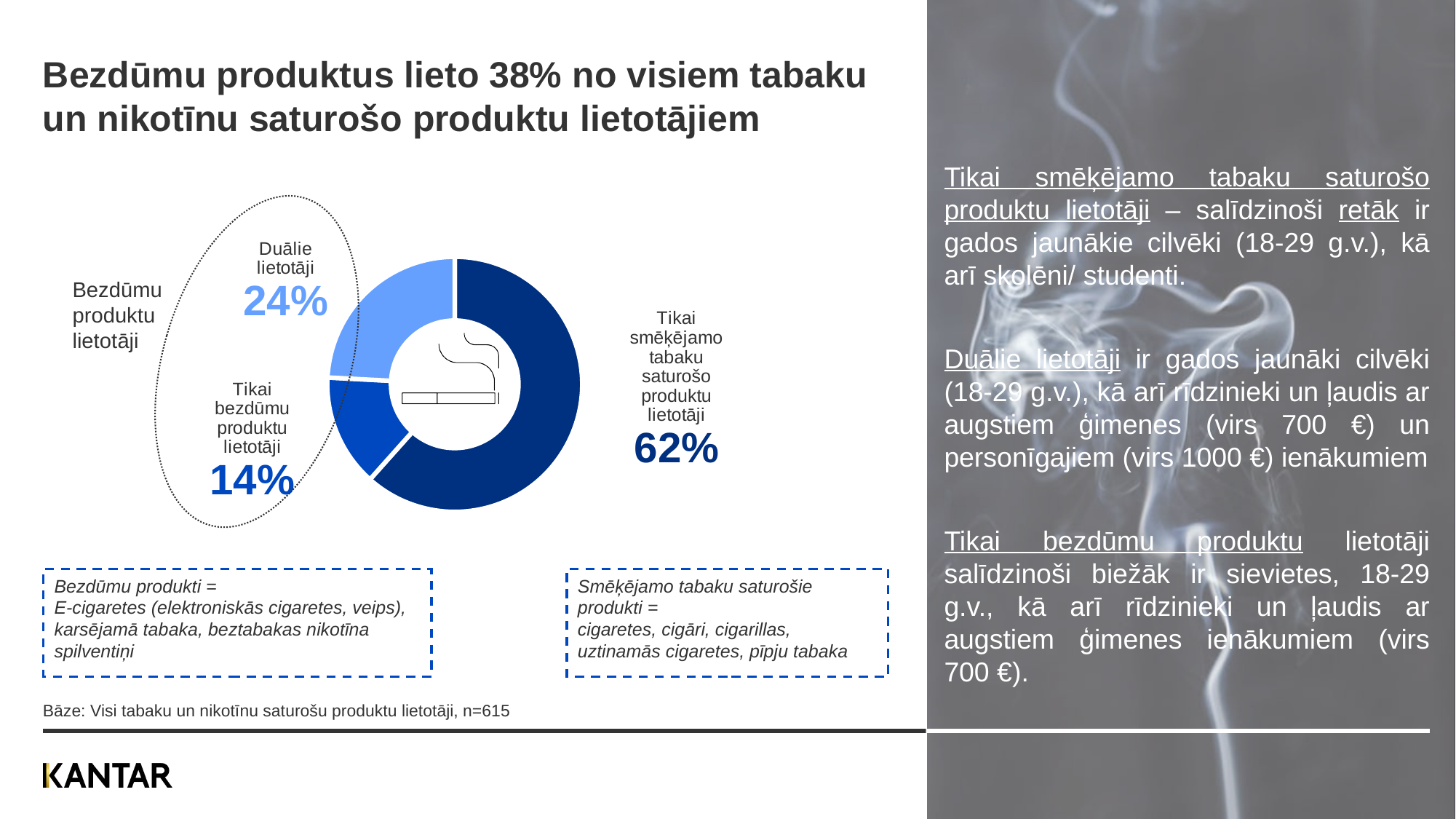
What is the difference in percentage points between 'Duālie lietotāji' and 'Tikai bezdūmu produktu lietotāji'? 10 percentage points Which is larger: the slice for 'Duālie lietotāji' or the slice for 'Tikai bezdūmu produktu lietotāji'? Duālie lietotāji What share of the pie is 'Tikai smēķējamo tabaku saturošo produktu lietotāji'? 62% Which category has the smallest slice of the pie? Tikai bezdūmu produktu lietotāji What is the base (n) stated below the chart? n=615 What is the difference in percentage points between 'Tikai smēķējamo tabaku saturošo produktu lietotāji' and 'Duālie lietotāji'? 38 percentage points What kind of chart is shown on the slide? Pie chart (doughnut) What share of the pie is 'Tikai bezdūmu produktu lietotāji'? 14% What is the combined share of the two slices grouped as 'Bezdūmu produktu lietotāji' (Duālie lietotāji and Tikai bezdūmu produktu lietotāji)? 38% What share of the pie is 'Duālie lietotāji'? 24% How many slices does the pie chart have? 3 Which category has the largest slice of the pie? Tikai smēķējamo tabaku saturošo produktu lietotāji